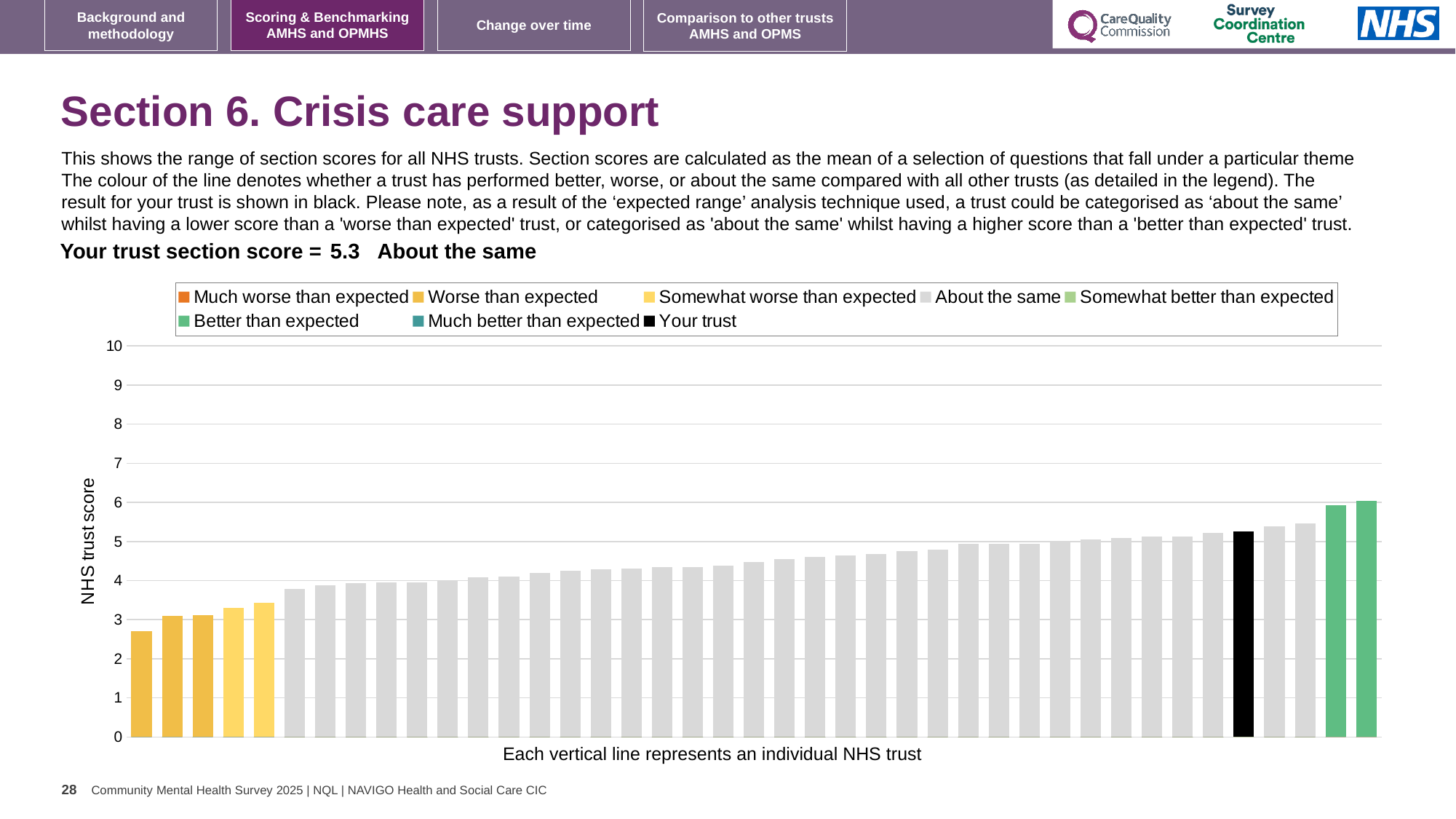
Is the value of the lowest bar in the chart greater or less than 3? less Which is larger: the value of the 'Your trust' bar or the value of the leftmost bar? Your trust Is the value of the highest bar in the chart greater or less than 7? less Is the value of the black 'Your trust' bar greater or less than 5? greater How many bars are coloured in the 'Worse than expected' colour? 3 How many entries does the chart legend list? 8 What is the label on the y axis of the chart? NHS trust score Which legend category does the highest bar in the chart belong to? Better than expected What is the section score for your trust shown on the slide? 5.3 What kind of chart is shown on the slide? bar chart Do the bar values rise or fall from left to right along the x axis? rise How many bars are coloured green ('Better than expected')? 2